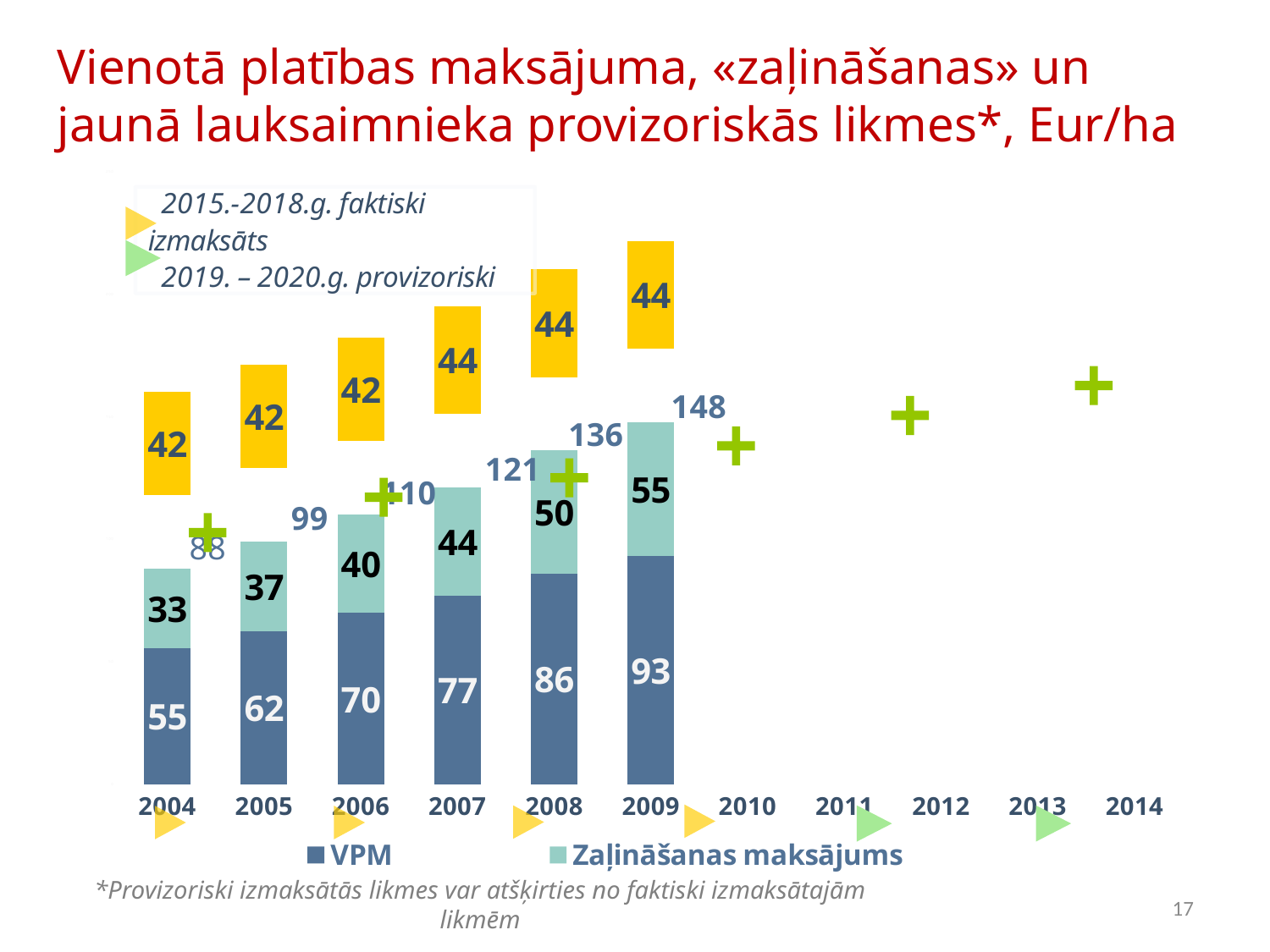
What is the total of the stacked bar labelled 2008? 136 Which is larger: the Zaļināšanas maksājums value for 2008 or for 2005? 2008 Do the VPM values rise or fall from the 2004 bar to the 2009 bar? rise What is the VPM value for the bar labelled 2009? 93 Which bar has the highest VPM value? 2009 What kind of chart is shown on the slide? stacked bar chart What is the total of the stacked bar labelled 2006? 110 What is the VPM value for the bar labelled 2004? 55 How many series does the legend list? 2 Which bar has the lowest Zaļināšanas maksājums value? 2004 What is the difference between the VPM values for the bars labelled 2009 and 2004? 38 What is the Zaļināšanas maksājums value for the bar labelled 2007? 44